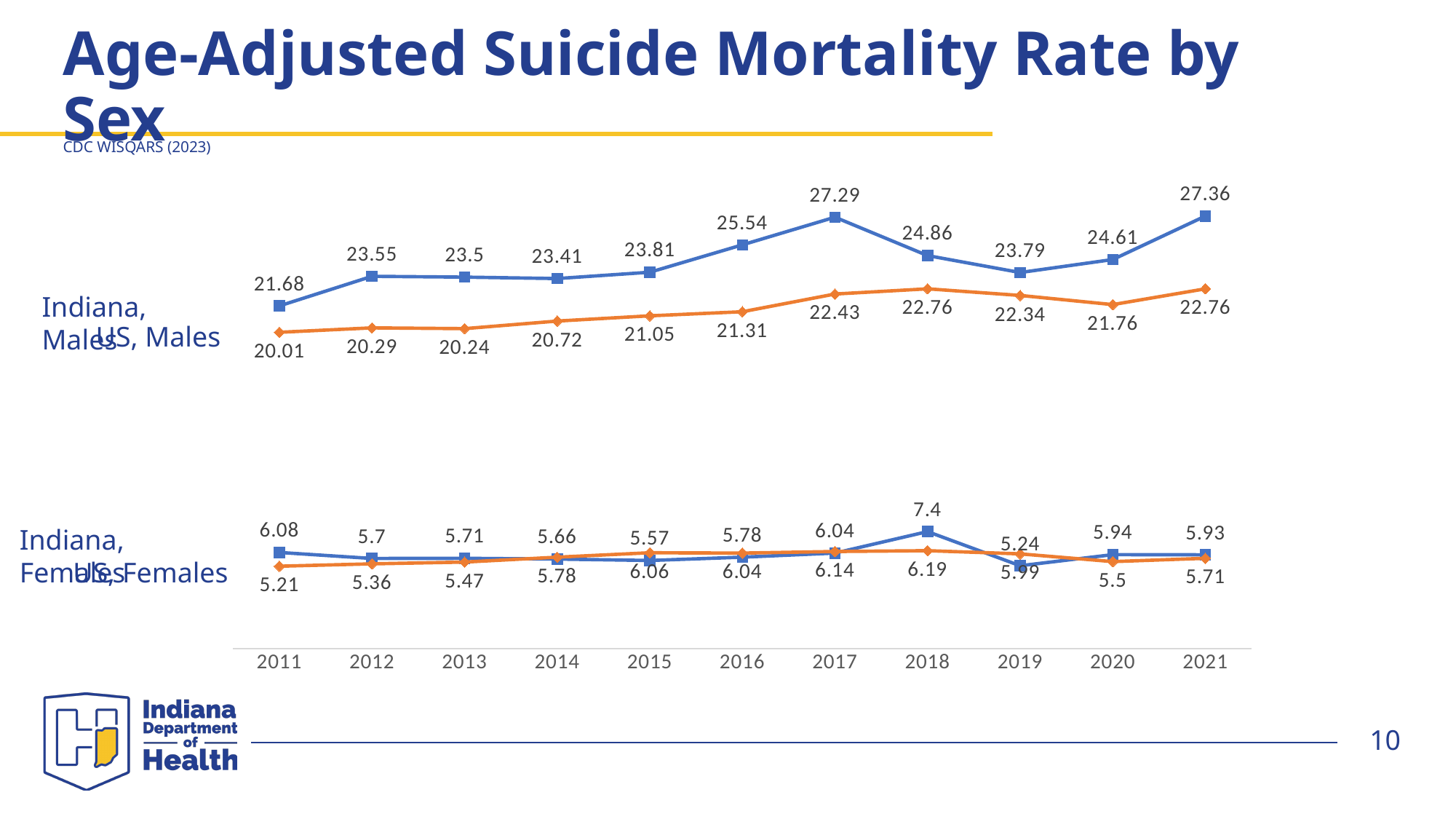
In 2019, which is larger: Indiana, Females or US, Females? US, Females What is the value for US, Males in 2011? 20.01 In which year is the US, Males rate lowest? 2011 How many years are shown on the x axis? 11 What is the difference between the Indiana, Males and US, Males values in 2021? 4.6 In which year is the Indiana, Males rate highest? 2021 What is the value for Indiana, Females in 2018? 7.4 Does the US, Males rate rise or fall from 2011 to 2021? Rise By how much did the Indiana, Males rate fall from 2017 to 2018? 2.43 What is the value for US, Females in 2020? 5.5 What kind of chart is shown on the slide? Line chart What is the value for Indiana, Males in 2021? 27.36